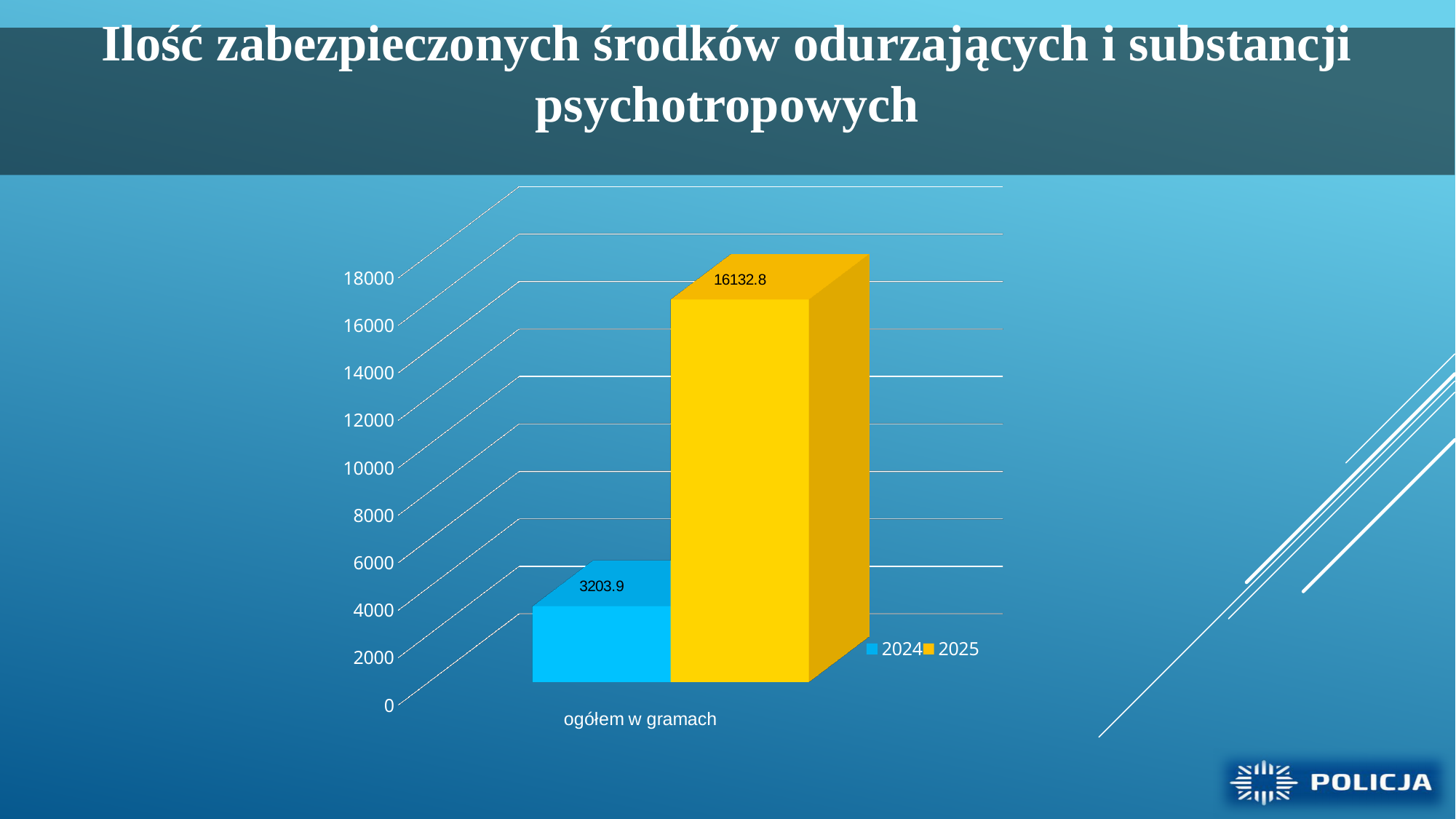
Which series has the higher value, 2024 or 2025? 2025 What kind of chart is shown on the slide? bar chart Is the value for 2025 greater or less than 14000? greater What colour is the bar for the 2025 series? yellow What is the difference between the 2025 and 2024 values? 12928.9 What is the value for 2025 in the 'ogółem w gramach' category? 16132.8 Is the value for 2024 greater or less than 4000? less What is the value for 2024 in the 'ogółem w gramach' category? 3203.9 How many categories are shown on the x axis? 1 How many series does the legend list? 2 Which series has the lowest value? 2024 What is the label of the category on the x axis? ogółem w gramach